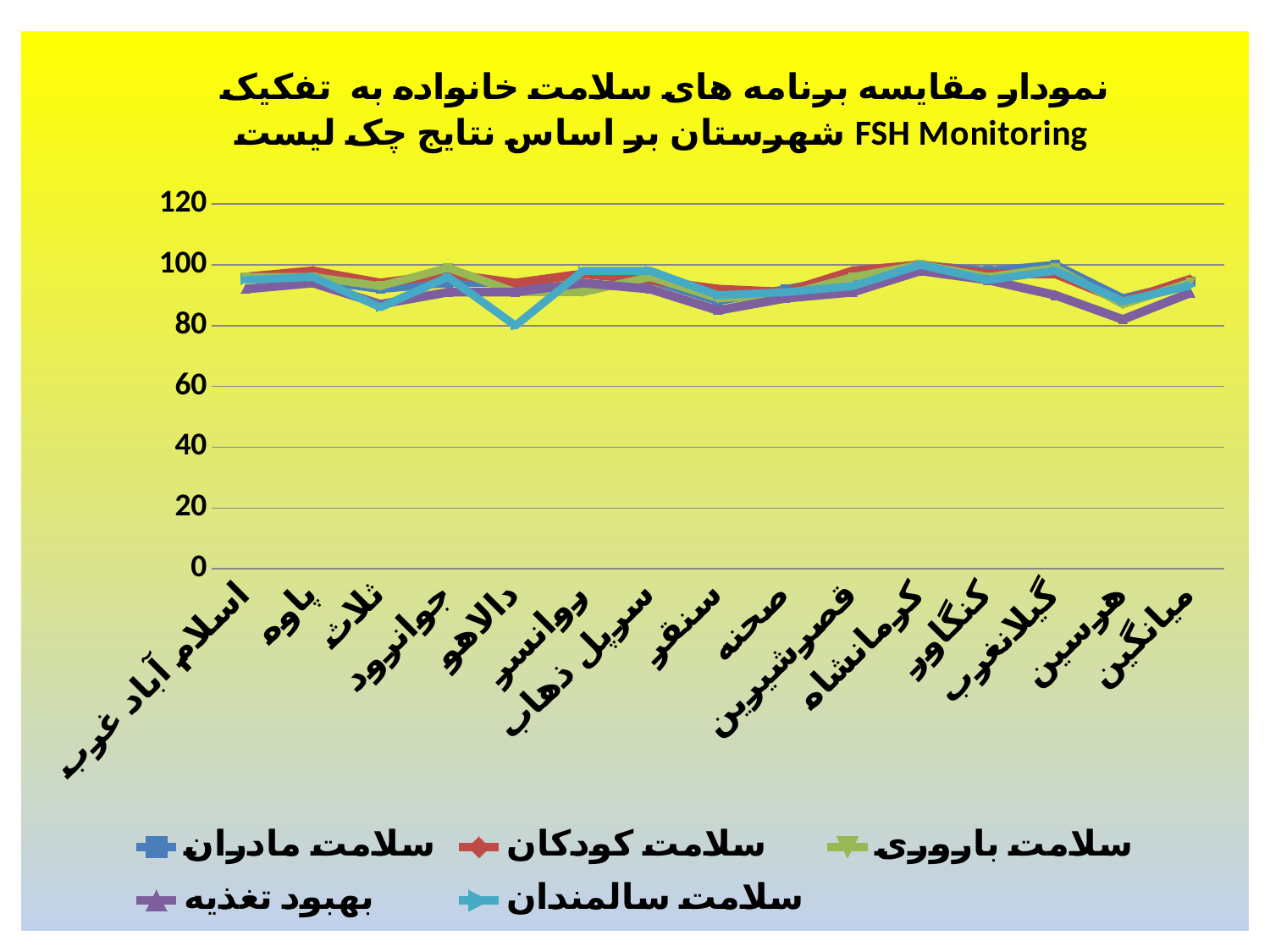
Which is larger for سلامت سالمندان: the value at دالاهو or the value at کرمانشاه? کرمانشاه Is the value for بهبود تغذیه at هرسین greater or less than 100? less How many series does the legend list? 5 What kind of chart is shown on the slide? line chart Is the value for سلامت کودکان at کرمانشاه greater or less than 80? greater Which series is drawn in purple? بهبود تغذیه Is the value for سلامت سالمندان at دالاهو greater or less than 100? less For the series سلامت سالمندان, which category has the lowest value? دالاهو What is the highest value shown on the y axis? 120 How many categories are shown along the x axis? 15